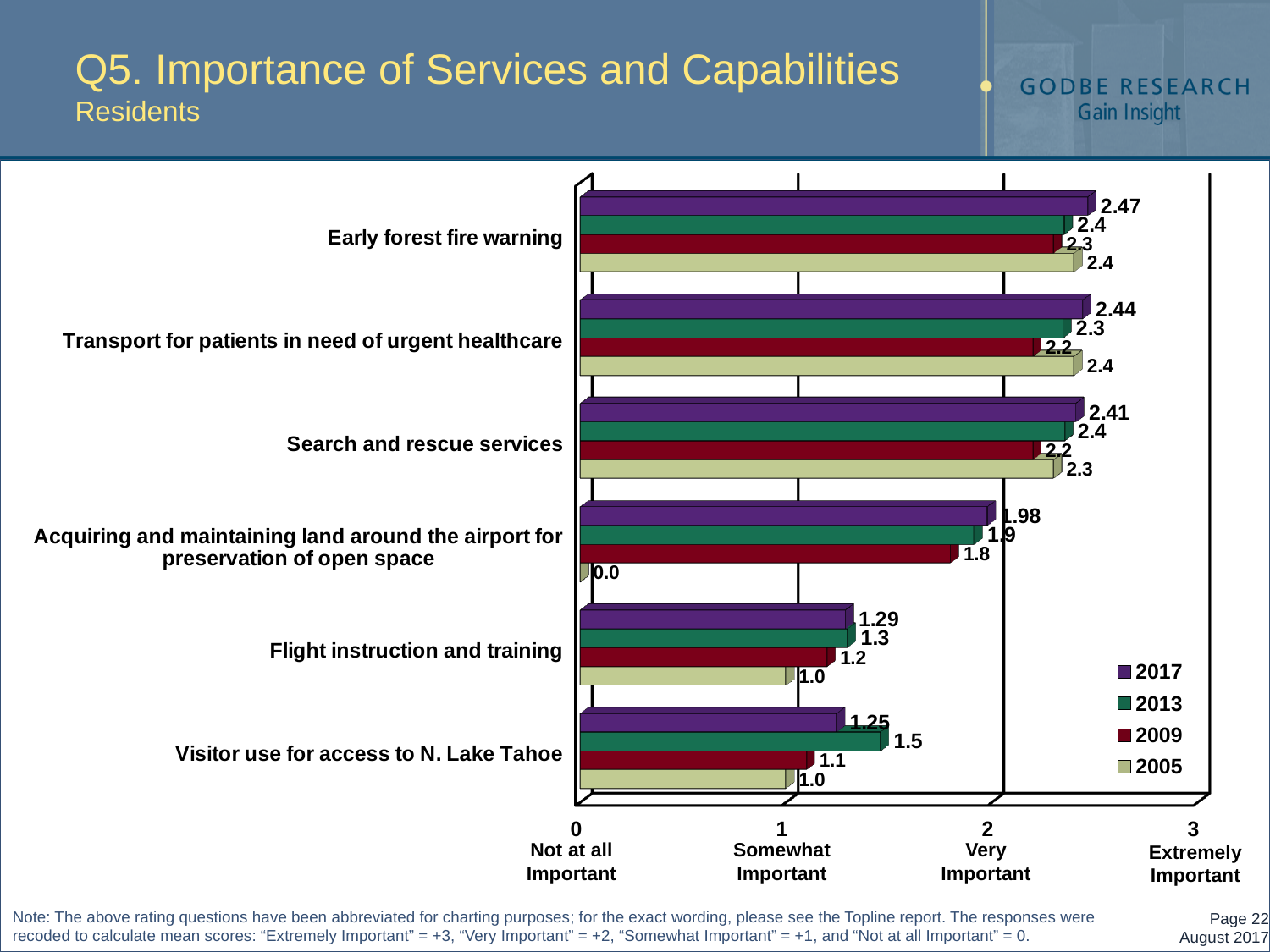
What is the difference between the 2017 and 2009 values for Search and rescue services? 0.21 What is the 2013 value for Visitor use for access to N. Lake Tahoe? 1.5 Which category has the highest 2017 value? Early forest fire warning What label is shown at the value 3 on the axis? Extremely Important What is the 2009 value for Transport for patients in need of urgent healthcare? 2.2 What kind of chart is shown on the slide? Bar chart How many series does the legend list? 4 For Visitor use for access to N. Lake Tahoe, which is larger: the 2013 value or the 2017 value? 2013 How many categories are shown on the chart? 6 What is the 2005 value for Acquiring and maintaining land around the airport for preservation of open space? 0.0 What is the 2017 value for Early forest fire warning? 2.47 Which category has the lowest 2017 value? Visitor use for access to N. Lake Tahoe